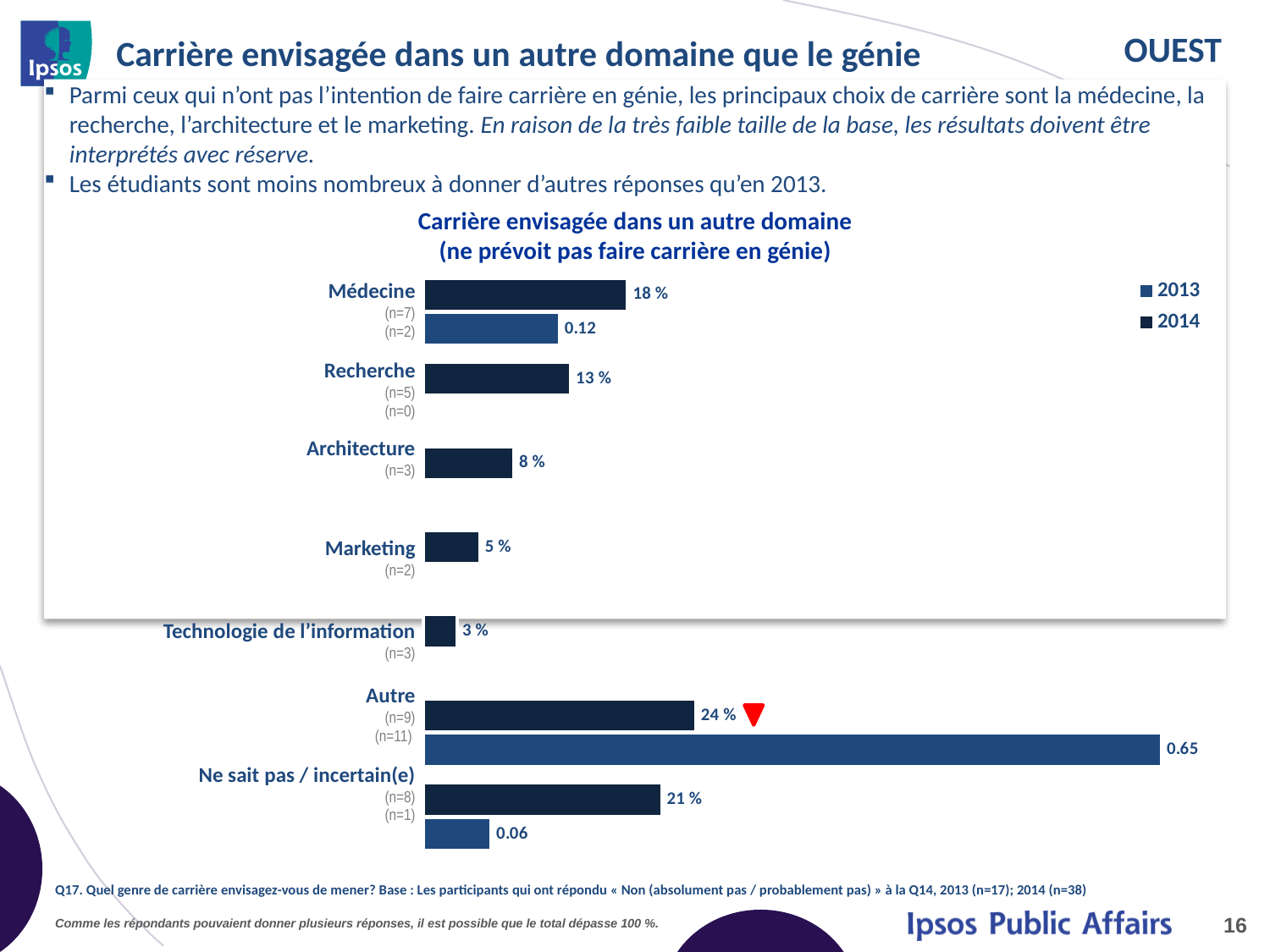
How many series does the legend list? 2 Which category has the lowest 2013 value? Ne sait pas / incertain(e) What is the 2014 value for Ne sait pas / incertain(e)? 21 % Which has the larger 2013 value, Autre or Ne sait pas / incertain(e)? Autre How many categories are shown on the chart? 7 Which category has the highest 2013 value? Autre What is the 2014 value for Autre? 24 % What kind of chart is shown on the slide? Bar chart What is the 2013 value for Médecine? 0.12